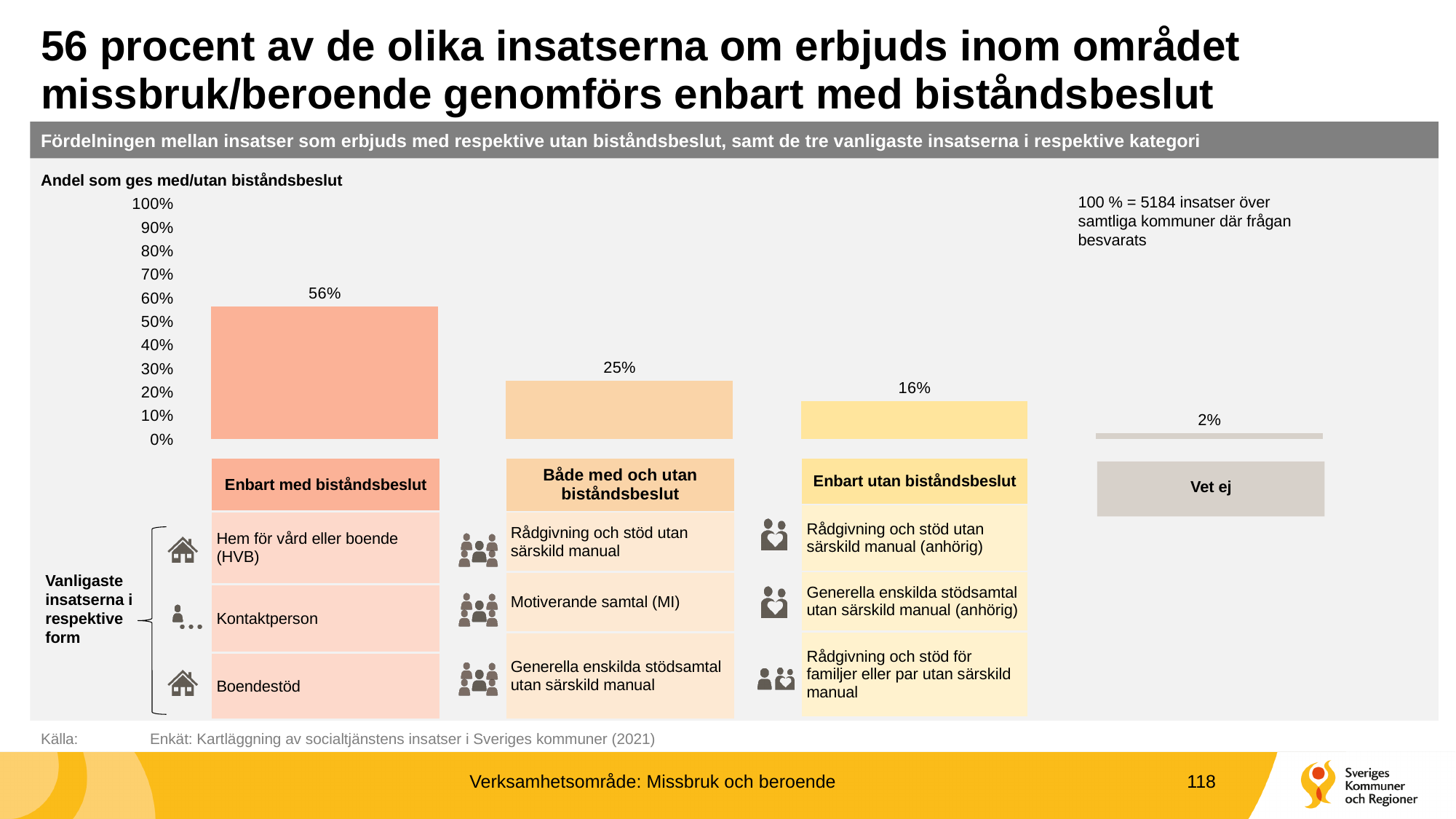
What is the value for "Både med och utan biståndsbeslut"? 25% Is the value for "Enbart med biståndsbeslut" greater or less than 50%? greater Which category has the highest value? Enbart med biståndsbeslut Which is larger, "Både med och utan biståndsbeslut" or "Enbart utan biståndsbeslut"? Både med och utan biståndsbeslut What is the difference between "Enbart med biståndsbeslut" and "Både med och utan biståndsbeslut"? 31 percentage points What is the total number of insatser that 100% corresponds to, according to the note on the chart? 5184 What is the value for "Vet ej"? 2% What is the value for "Enbart utan biståndsbeslut"? 16% Which category has the lowest value? Vet ej What is the value for "Enbart med biståndsbeslut"? 56% What kind of chart is shown on the slide? Bar chart How many categories are shown in the chart? 4